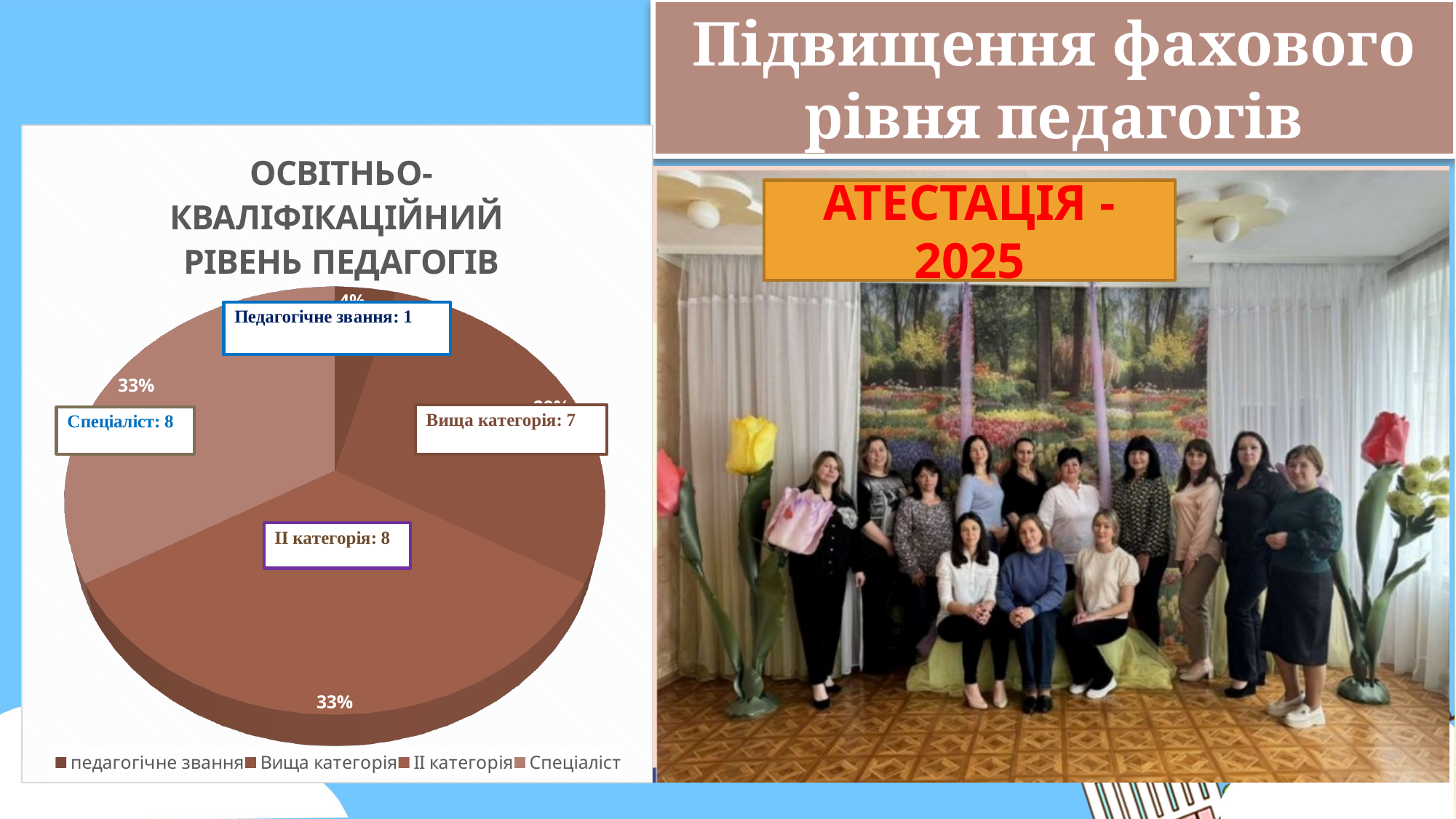
Which category has the smallest value in the pie chart? Педагогічне звання What is the value shown for 'Педагогічне звання' in the chart? 1 What kind of chart is shown on the slide? pie chart How many categories does the pie chart show? 4 What is the value shown for 'Спеціаліст' in the chart? 8 Which is larger: the value for 'Вища категорія' or for 'Педагогічне звання'? Вища категорія What is the value shown for 'ІІ категорія' in the chart? 8 What is the title of the pie chart? ОСВІТНЬО-КВАЛІФІКАЦІЙНИЙ РІВЕНЬ ПЕДАГОГІВ What is the difference between the values for 'Спеціаліст' and 'Вища категорія'? 1 What share of the pie does 'Спеціаліст' represent? 33% How many teachers are in the 'Вища категорія' group according to the chart? 7 What is the total of all four values shown in the pie chart? 24